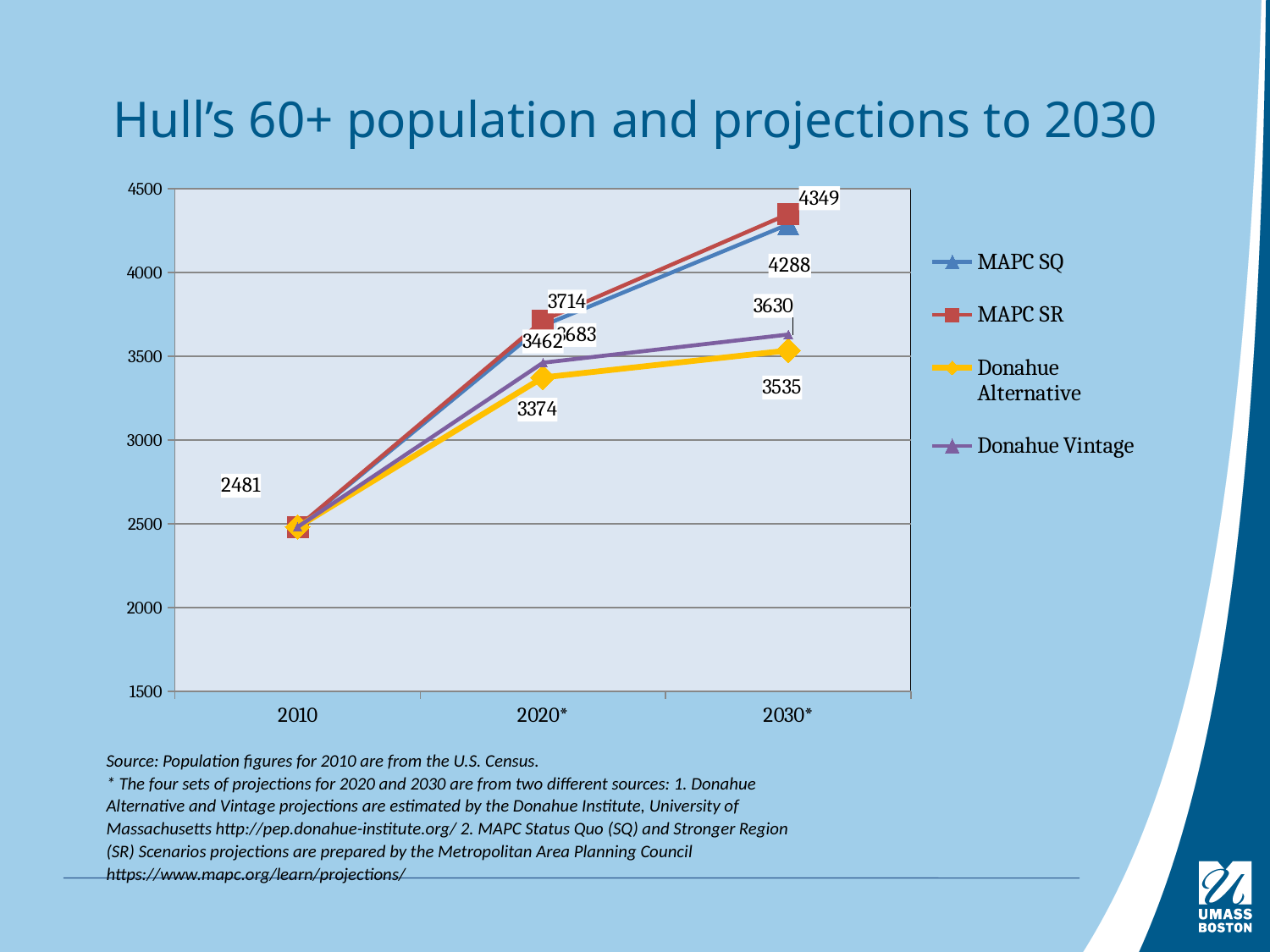
What is the Donahue Alternative projection for 2020*? 3374 What is the 2010 value shown on the chart? 2481 Which is larger at 2020*: the MAPC SR projection or the Donahue Alternative projection? MAPC SR Do the values for MAPC SR rise or fall from 2010 to 2030*? Rise What is the difference between the MAPC SR and MAPC SQ projections for 2030*? 61 Which series has the highest value at 2030*? MAPC SR How many series does the legend list? 4 What is the MAPC SQ projection for 2030*? 4288 What is the Donahue Vintage projection for 2030*? 3630 What kind of chart is shown on the slide? Line chart Which series has the lowest value at 2030*? Donahue Alternative What is the MAPC SR projection for 2030*? 4349